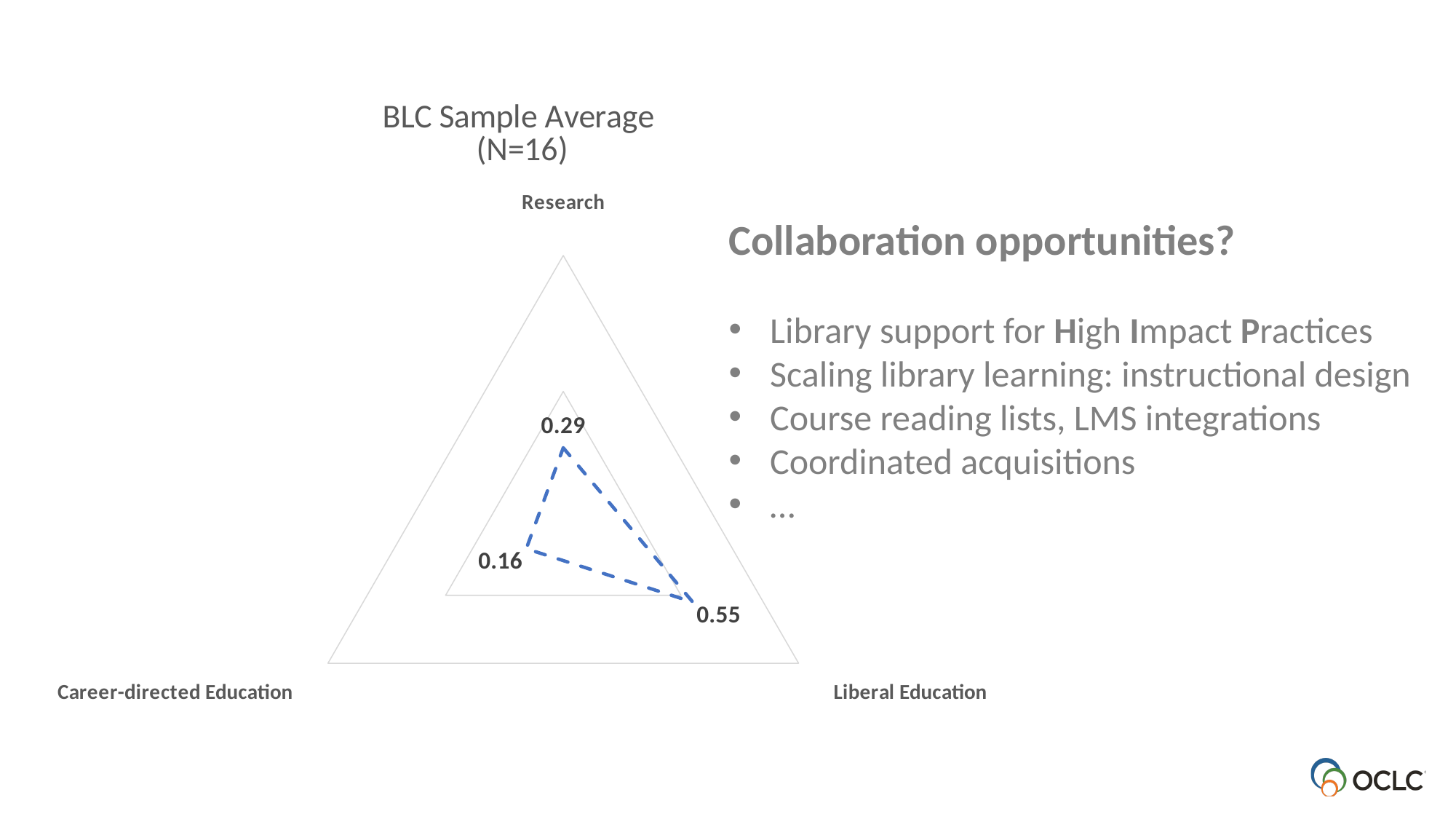
What is the sample size (N) stated in the chart title? 16 What is the difference between the values for Research and Career-directed Education? 0.13 What is the value for Research on the radar chart? 0.29 Which is larger, the value for Research or the value for Career-directed Education? Research Which category has the lowest value on the radar chart? Career-directed Education What kind of chart is shown on the slide? Radar chart What is the value for Liberal Education on the radar chart? 0.55 What is the difference between the values for Liberal Education and Research? 0.26 Which category has the highest value on the radar chart? Liberal Education What is the value for Career-directed Education on the radar chart? 0.16 How many categories (axes) does the radar chart have? 3 What is the title of the chart? BLC Sample Average (N=16)